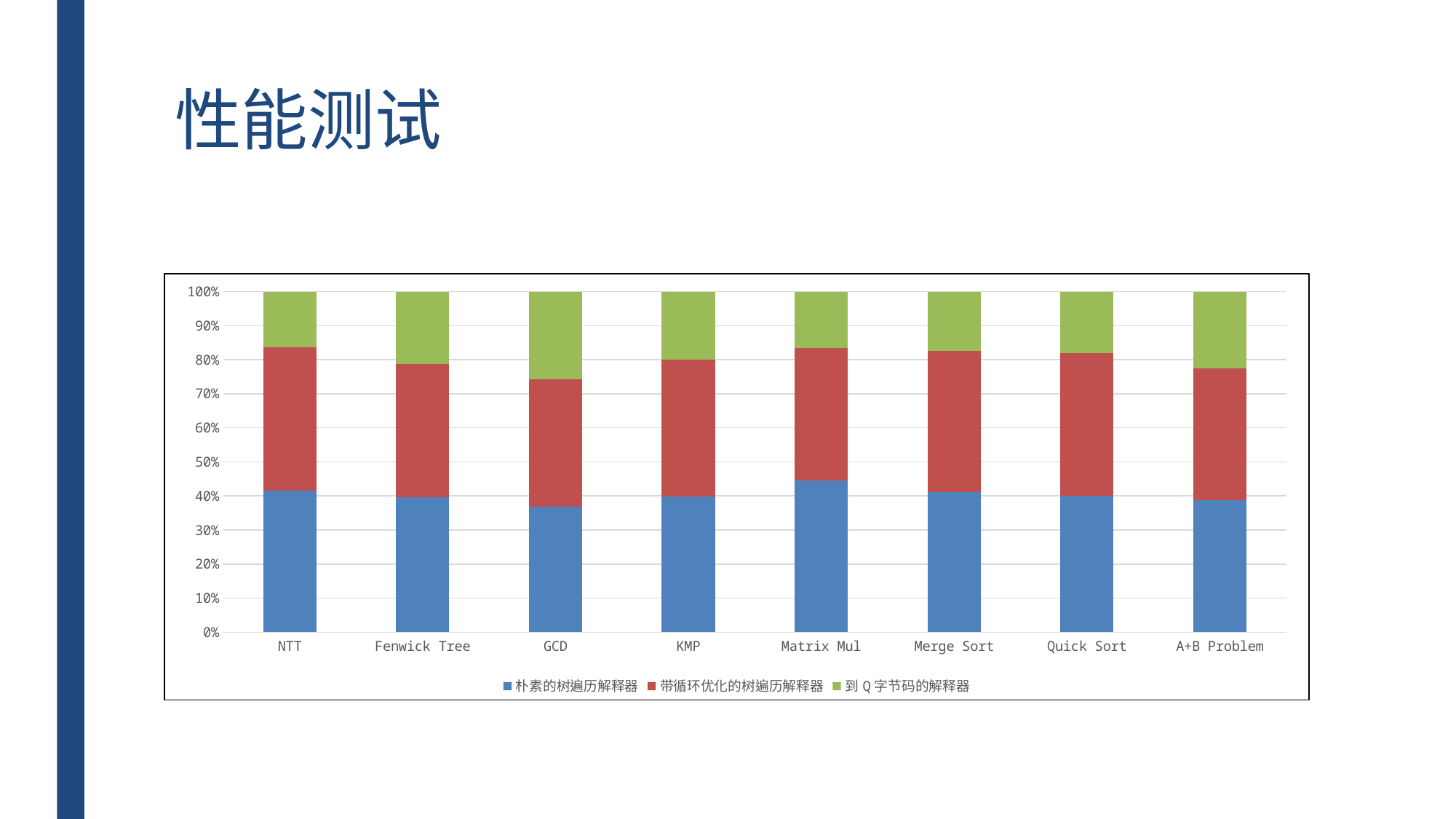
Is the blue (朴素的树遍历解释器) value for Matrix Mul greater or less than 40%? greater What kind of chart is shown on the slide? Stacked bar chart Is the blue (朴素的树遍历解释器) value for GCD greater or less than 40%? less Which category has the largest green (到 Q 字节码的解释器) segment? GCD Which colour represents the series 到 Q 字节码的解释器 in the legend? Green How many series does the chart's legend list? 3 Is the top of the red (带循环优化的树遍历解释器) segment for NTT greater or less than 80%? greater How many categories are shown on the x axis of the chart? 8 Which category has the largest blue (朴素的树遍历解释器) segment? Matrix Mul Which category has the smallest blue (朴素的树遍历解释器) segment? GCD What is the total height of the stacked bar for NTT? 100%